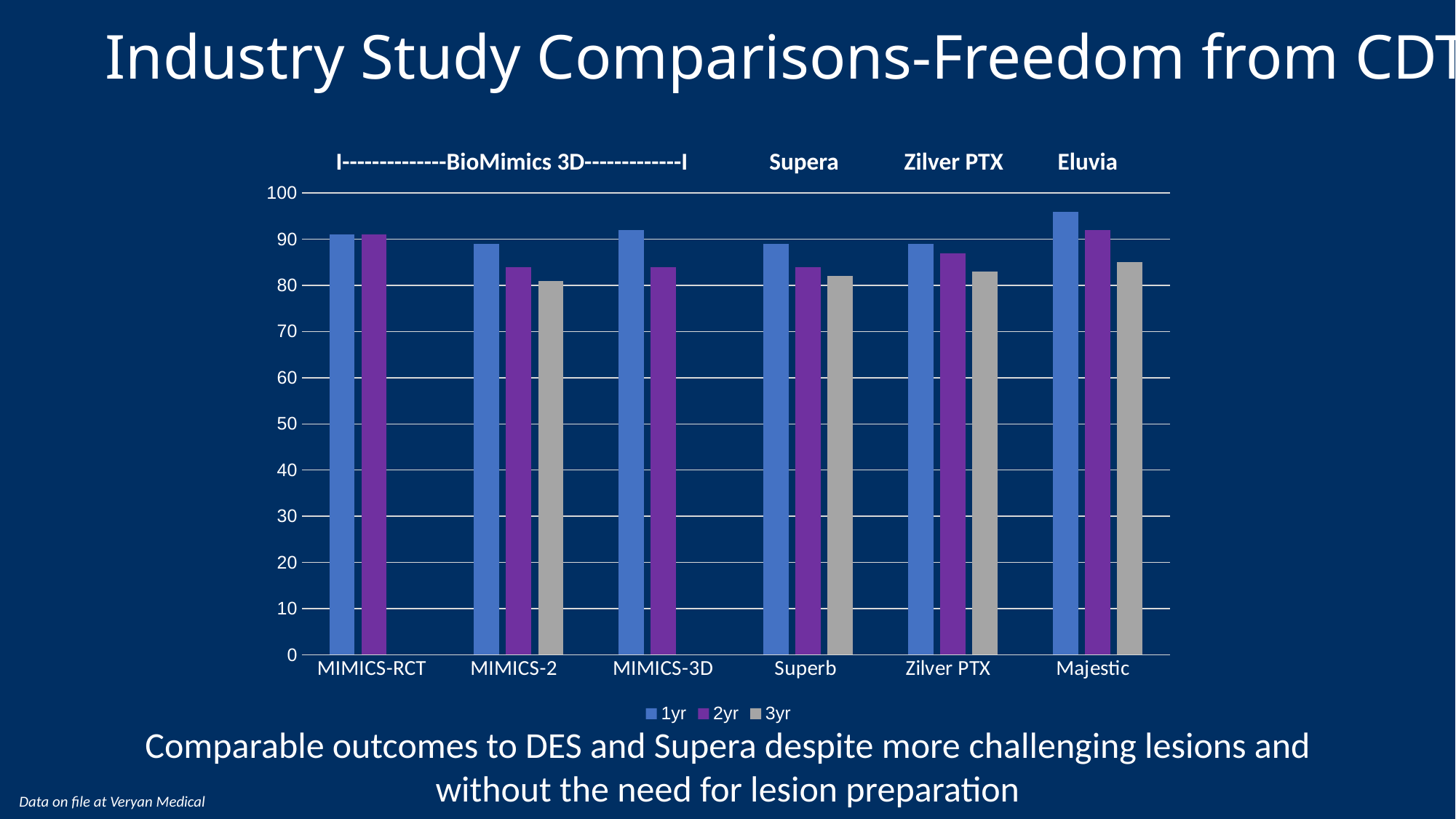
Is the 3yr value for Superb greater or less than 70? greater Is the 1yr value for Majestic greater or less than 90? greater Is the 2yr value for MIMICS-RCT greater or less than 80? greater Which is larger, the 1yr value for Majestic or the 1yr value for MIMICS-2? Majestic Which category has no 3yr bar plotted? MIMICS-RCT and MIMICS-3D What colour are the 3yr bars in the chart? grey Which is larger for MIMICS-3D, the 1yr value or the 2yr value? 1yr What kind of chart is shown on the slide? bar chart Which category has the highest 1yr value? Majestic How many categories are shown on the x axis of the chart? 6 How many series does the legend list? 3